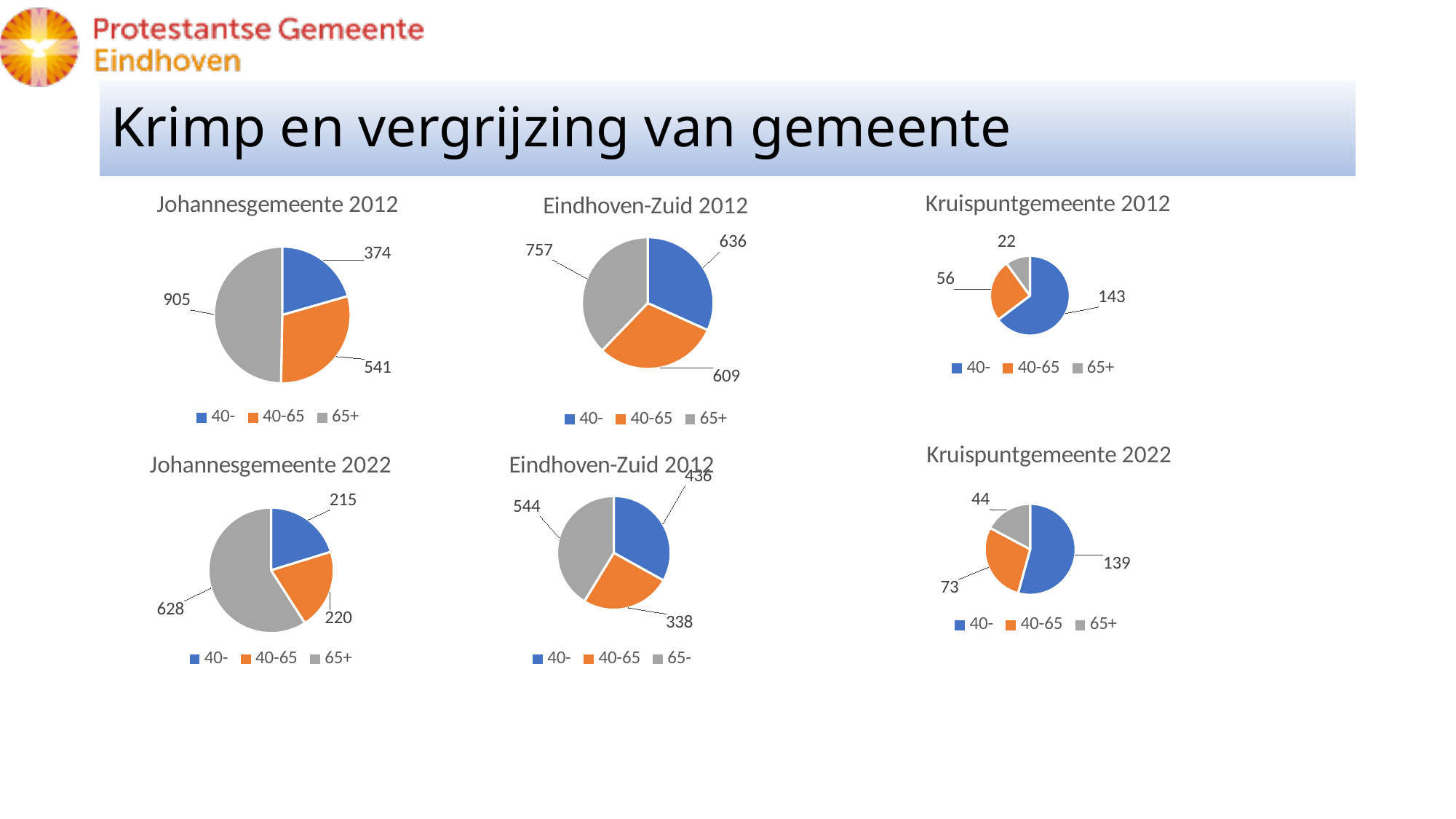
In the Kruispuntgemeente 2012 chart, which category has the smallest slice? 65+ How many entries does the legend of the Kruispuntgemeente 2012 chart list? 3 In the Kruispuntgemeente 2022 chart, what is the value for the 40-65 slice? 73 In the Johannesgemeente 2022 chart, how much larger is the 65+ value than the 40- value? 413 In the top-middle Eindhoven-Zuid 2012 chart, which is larger: the 40- slice or the 40-65 slice? 40- What kind of chart is the Johannesgemeente 2012 chart? pie chart How many pie charts are shown on the slide? 6 In the bottom-middle chart (Eindhoven-Zuid, bottom row), what is the value for the 40-65 slice? 338 What is the total of all slices in the Kruispuntgemeente 2022 chart? 256 In the top-middle Eindhoven-Zuid 2012 chart, which category has the largest slice? 65+ In the Johannesgemeente 2012 chart, what is the value for the 65+ slice? 905 How many slices does the Johannesgemeente 2022 pie chart have? 3